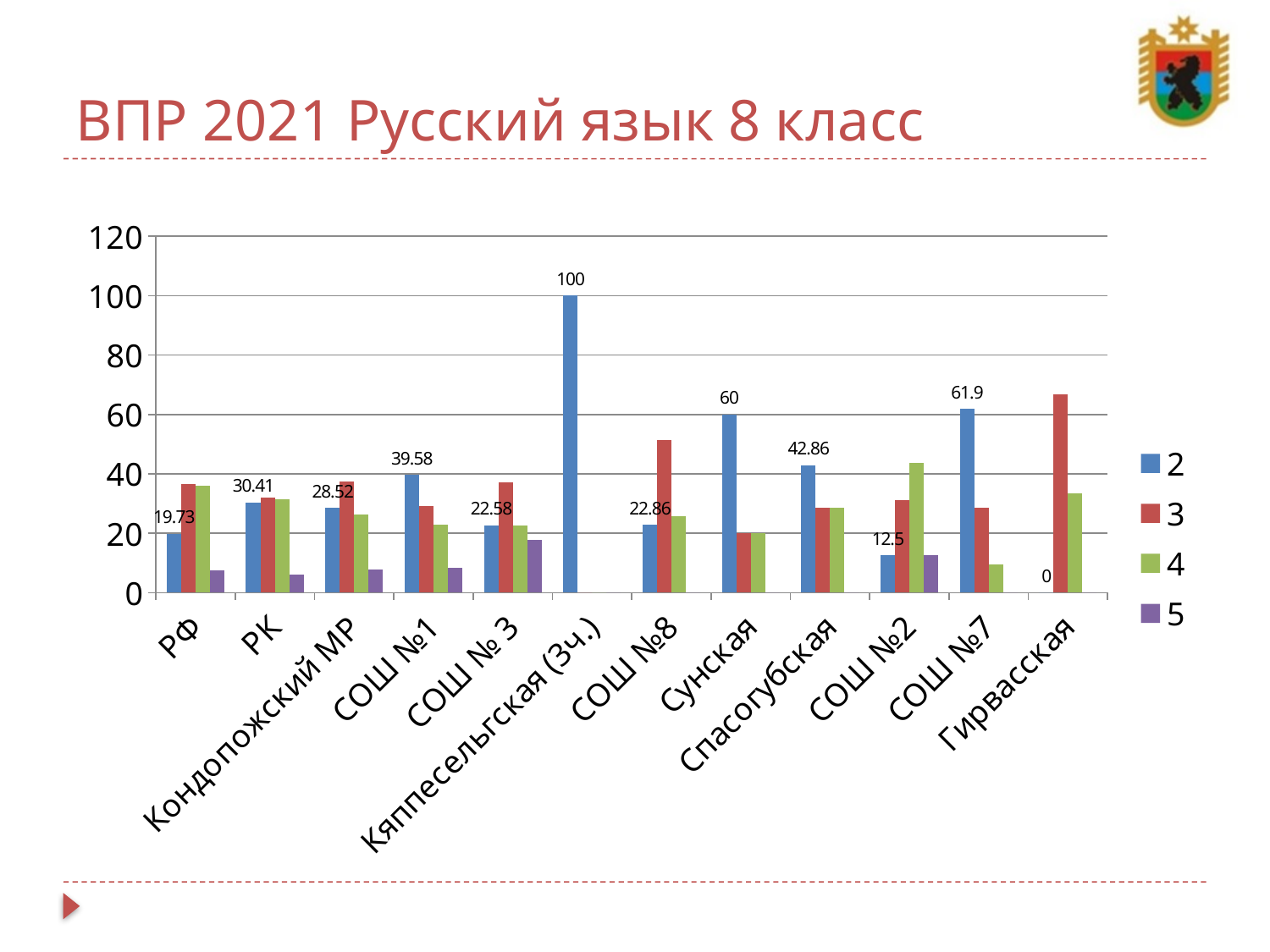
Which category has the lowest value for series 2? Гирвасская What is the value of series 2 for СОШ №7? 61.9 Which has a larger series 2 value, РК or Кондопожский МР? РК What is the value of series 2 for Кяппесельгская (3ч.)? 100 What is the title of the slide? ВПР 2021 Русский язык 8 класс What is the difference between the series 2 values for Сунская and СОШ №8? 37.14 How many series does the legend list? 4 How many categories are shown on the x axis? 12 What kind of chart is shown on the slide? bar chart What is the value of series 2 for Спасогубская? 42.86 Is the value of series 3 for Гирвасская greater or less than 60? greater Which category has the highest value for series 2? Кяппесельгская (3ч.)